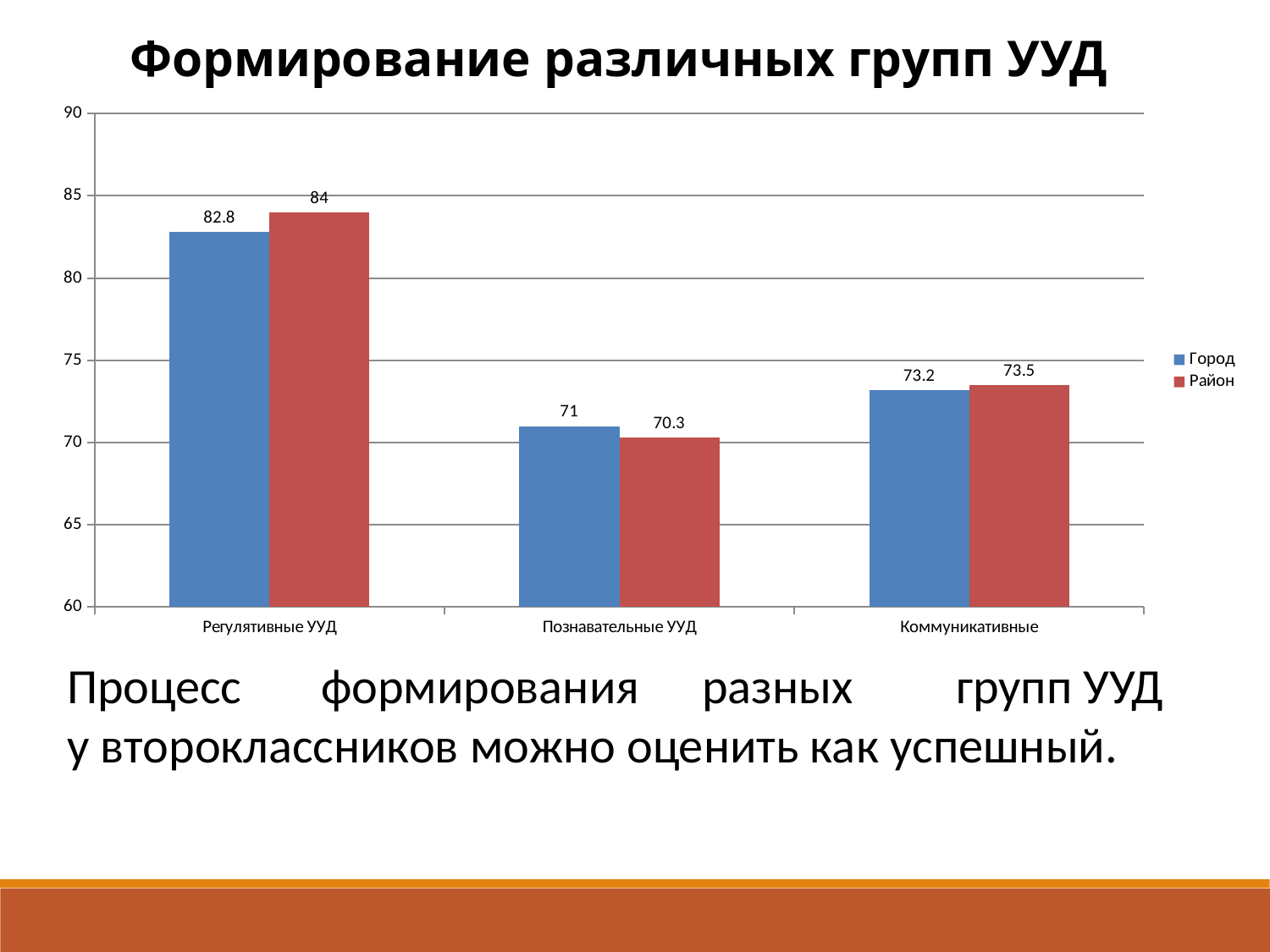
Which category has the highest value for Район? Регулятивные УУД How many series does the legend list? 2 What is the difference between the Район and Город values for Регулятивные УУД? 1.2 How many categories are shown on the x axis? 3 What is the value for Район for Познавательные УУД? 70.3 Which is larger for Познавательные УУД: Город or Район? Город What is the title of the chart? Формирование различных групп УУД What is the value for Район for Коммуникативные? 73.5 What kind of chart is shown on the slide? bar chart What is the value for Город for Регулятивные УУД? 82.8 Is the value for Город for Коммуникативные greater or less than 75? less Which category has the lowest value for Город? Познавательные УУД